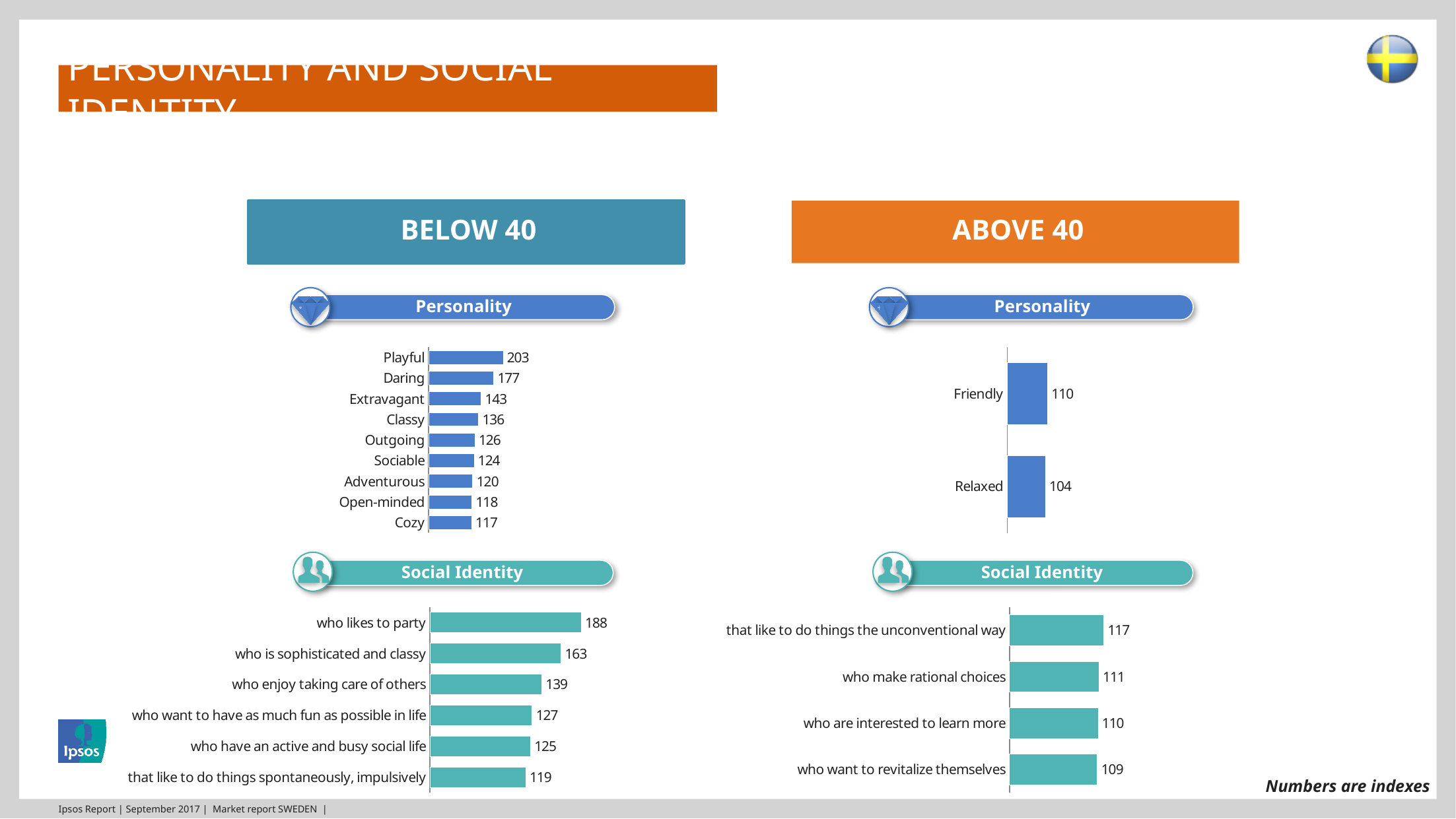
In the Above 40 Personality chart, which is larger, Friendly or Relaxed? Friendly In the Below 40 Personality chart, what is the value for Playful? 203 In the Below 40 Personality chart, what is the difference between Playful and Daring? 26 In the Above 40 Personality chart, what is the value for Relaxed? 104 In the Above 40 Social Identity chart, what is the difference between 'that like to do things the unconventional way' and 'who want to revitalize themselves'? 8 What kind of chart is the Below 40 Social Identity chart? Bar chart In the Below 40 Social Identity chart, which category has the highest value? who likes to party In the Below 40 Social Identity chart, what is the value for 'who is sophisticated and classy'? 163 How many categories are shown in the Below 40 Personality chart? 9 How many categories are shown in the Below 40 Social Identity chart? 6 In the Below 40 Personality chart, which category has the lowest value? Cozy In the Above 40 Social Identity chart, what is the value for 'who make rational choices'? 111